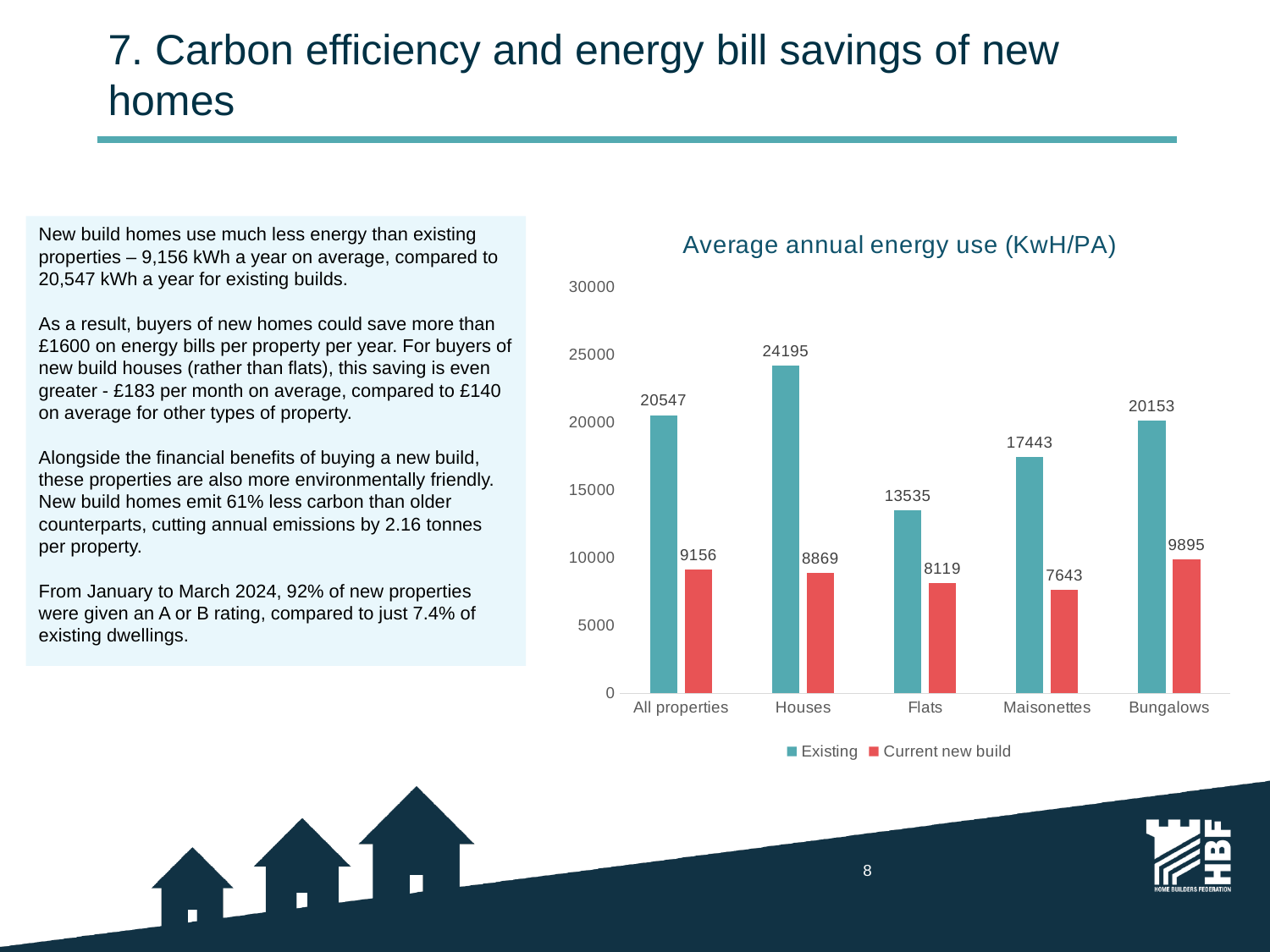
How many series does the legend list? 2 What is the Existing value for Houses? 24195 Which is larger: the Current new build value for Bungalows or for Flats? Bungalows Which category has the highest Existing value? Houses How many categories are shown on the x axis? 5 Which category has the lowest Current new build value? Maisonettes What is the Current new build value for Maisonettes? 7643 What kind of chart is shown on the slide? bar chart What is the Existing value for Bungalows? 20153 Is the Existing value for Flats greater or less than 15000? less What is the difference between the Existing and Current new build values for All properties? 11391 What is the title of the chart? Average annual energy use (KwH/PA)